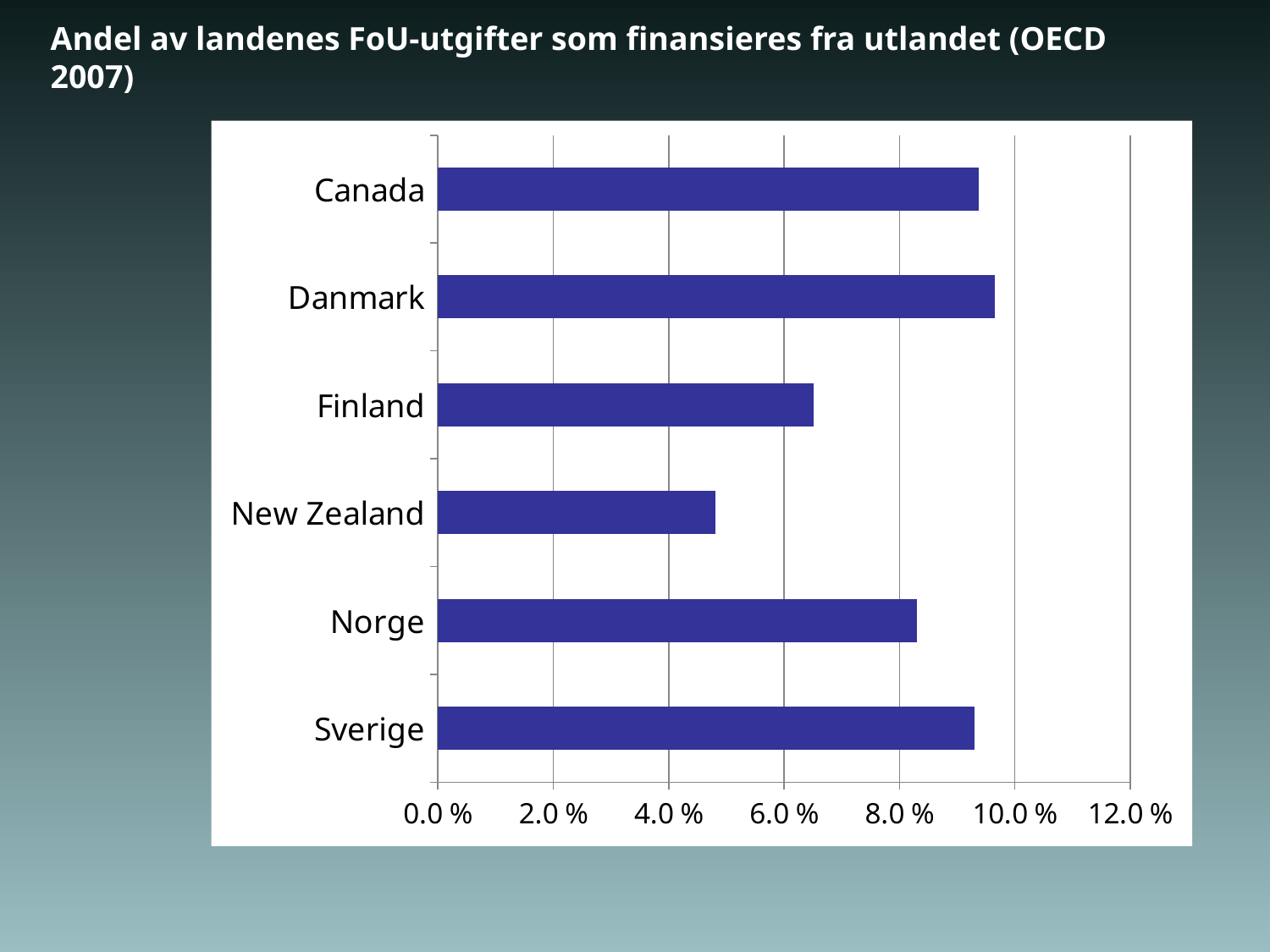
Which has a larger value, Finland or New Zealand? Finland Is the value for Finland greater or less than 6.0 %? greater How many countries are shown in the chart? 6 Which has a larger value, Norge or Finland? Norge Is the value for Canada greater or less than 8.0 %? greater Is the value for New Zealand greater or less than 6.0 %? less Which country has the lowest share of R&D expenditure financed from abroad? New Zealand What kind of chart is shown on the slide? bar chart What is the title of the slide? Andel av landenes FoU-utgifter som finansieres fra utlandet (OECD 2007) Which has a larger value, Danmark or Norge? Danmark